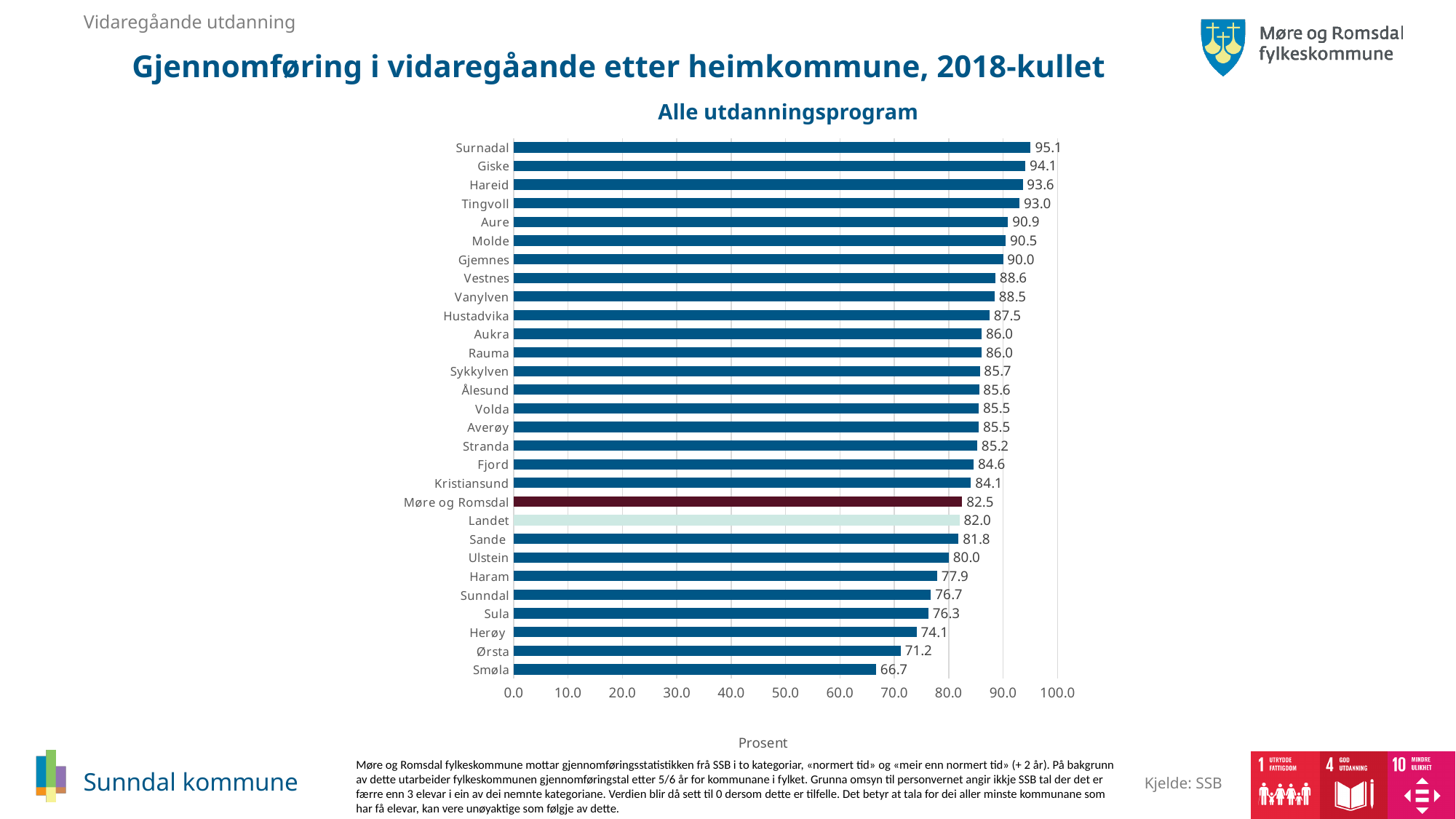
What is the title of the chart? Alle utdanningsprogram Which is larger, the value for Molde or the value for Kristiansund? Molde What is the value for Møre og Romsdal? 82.5 What is the difference between the values for Møre og Romsdal and Sunndal? 5.8 Which category has the highest value? Surnadal What is the value for Sunndal? 76.7 What is the difference between the values for Surnadal and Smøla? 28.4 What kind of chart is shown on the slide? bar chart How many categories are shown in the chart? 29 Is the value for Ørsta greater or less than 80.0? less Which category has the lowest value? Smøla What is the value for Landet? 82.0